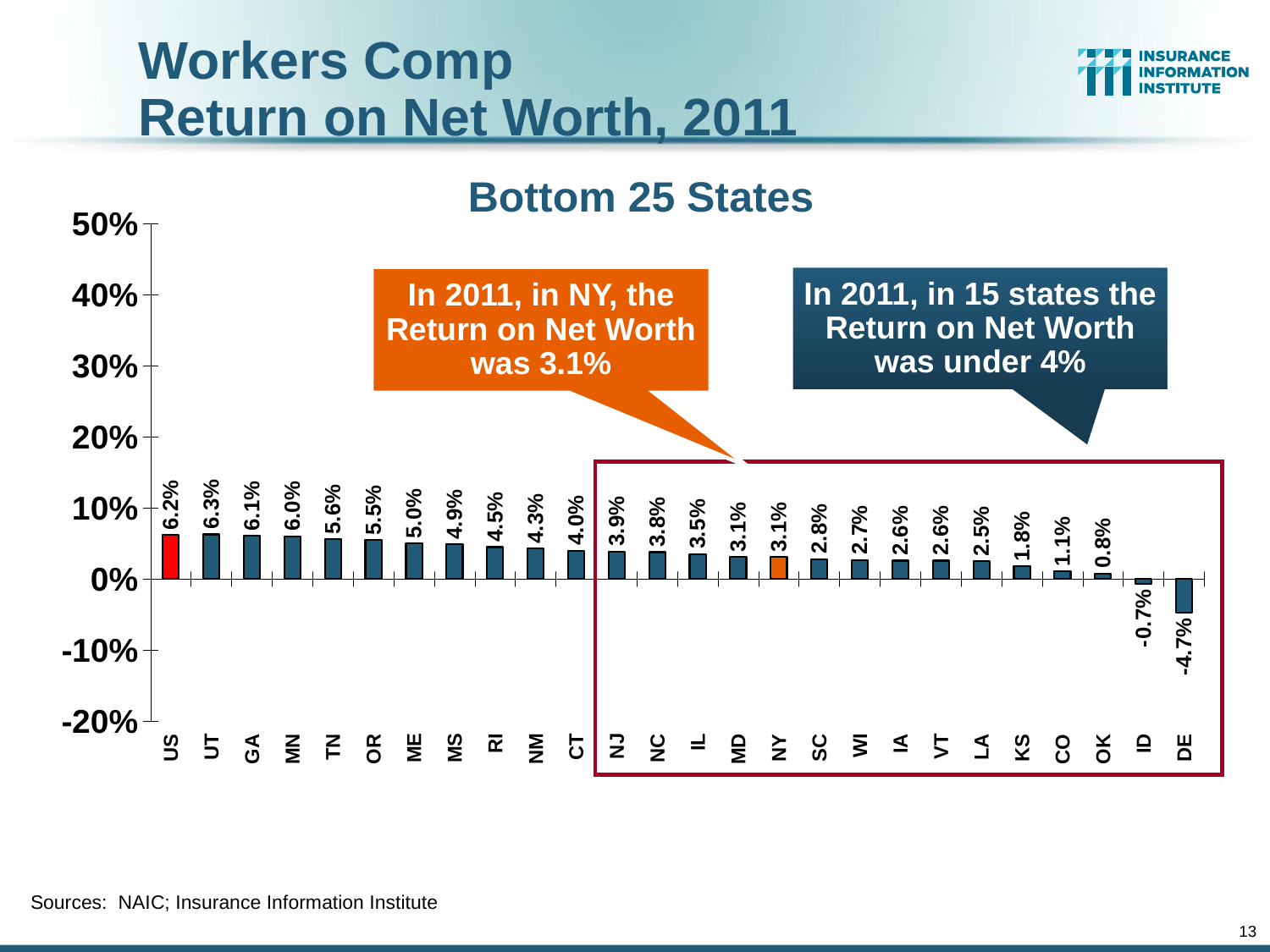
What is the Return on Net Worth for DE? -4.7% Which state has the lowest Return on Net Worth? DE What is the difference between the Return on Net Worth for UT and for CT? 2.3% What is the Return on Net Worth for the US overall? 6.2% What is the Return on Net Worth for KS? 1.8% Which has a higher Return on Net Worth, TN or SC? TN Do the values generally rise or fall moving from left to right along the x axis? Fall Which category has the highest Return on Net Worth? UT How many bars are plotted on the chart? 26 What is the Return on Net Worth for NY? 3.1% Which bar is highlighted in red? US What type of chart is shown? Bar chart